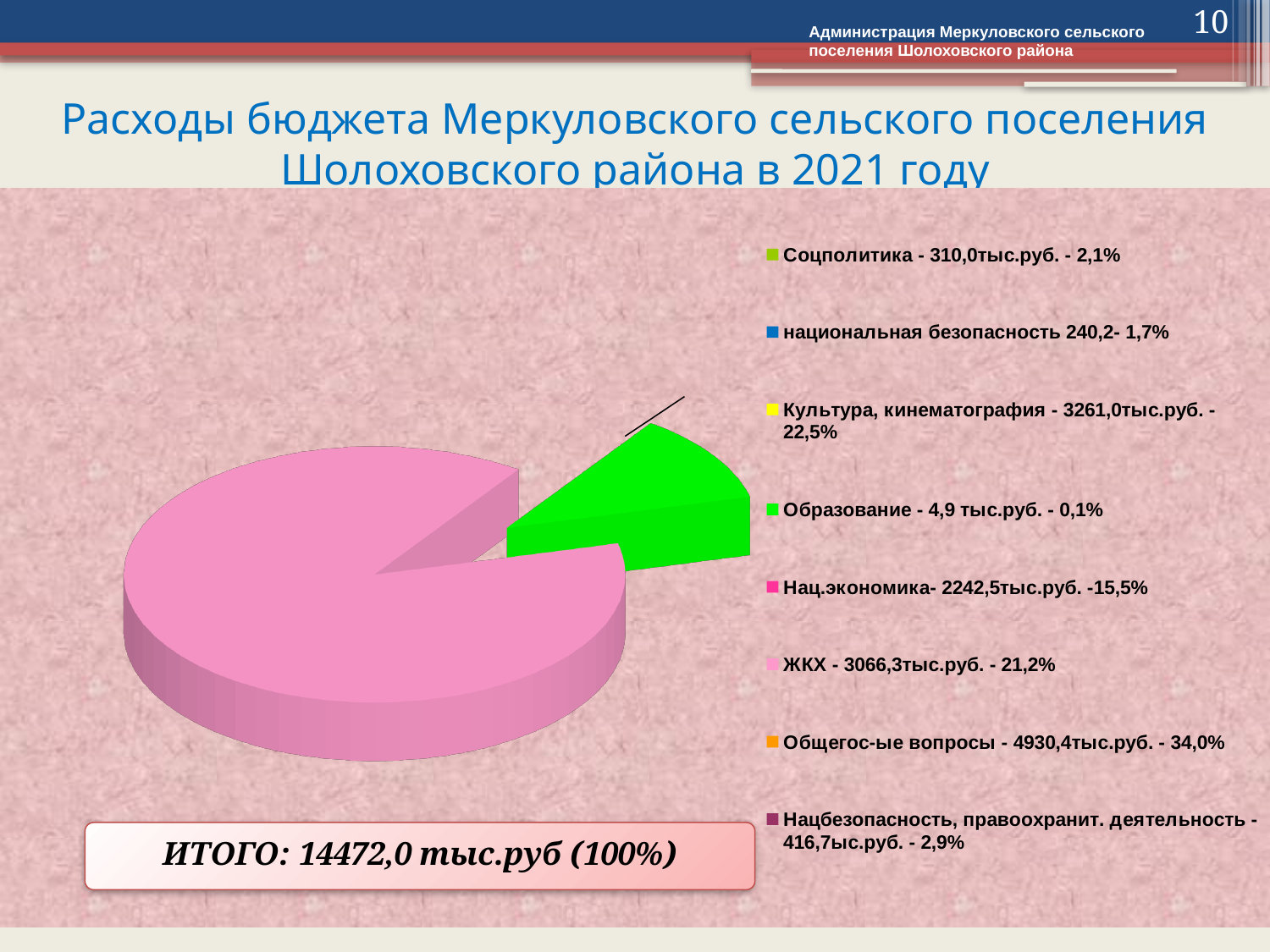
Which category has the largest share of expenditures? Общегос-ые вопросы What kind of chart is shown on the slide? pie chart What is the difference in percentage points between Общегос-ые вопросы (34,0%) and Культура, кинематография (22,5%)? 11,5% What percentage share is shown for ЖКХ? 21,2% What total amount (ИТОГО) is shown on the slide? 14472,0 тыс.руб (100%) What is the amount shown for Нац.экономика? 2242,5тыс.руб. What percentage is shown for Соцполитика? 2,1% Which is larger, the share for ЖКХ or the share for Нац.экономика? ЖКХ How many categories does the legend list? 8 What is the value for Культура, кинематография? 3261,0тыс.руб. - 22,5% Which category has the smallest share of expenditures? Образование What is the title of the chart on the slide? Расходы бюджета Меркуловского сельского поселения Шолоховского района в 2021 году